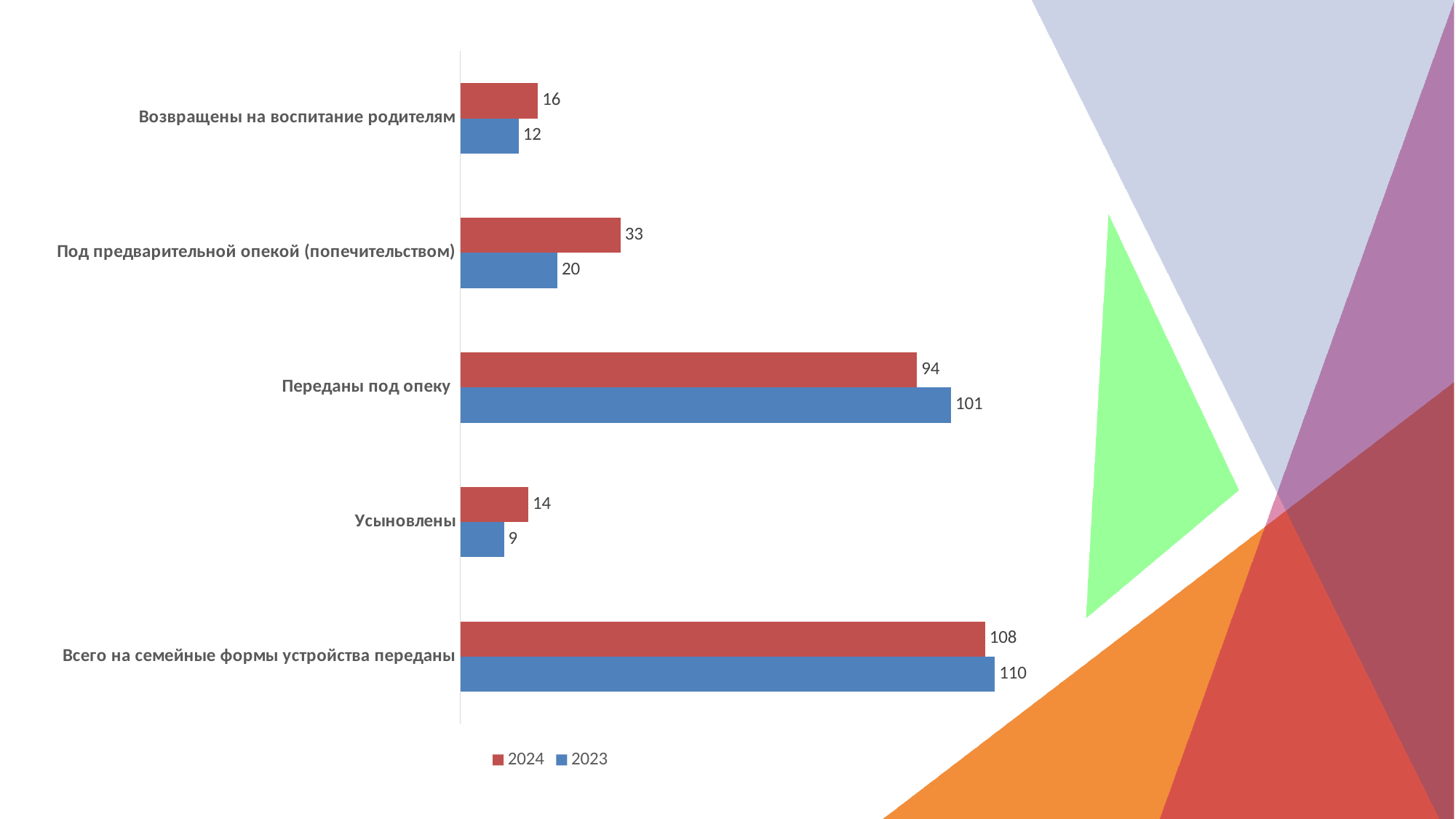
Which category has the lowest 2024 value? Усыновлены What is the difference between the 2024 and 2023 values for «Под предварительной опекой (попечительством)»? 13 Which is larger for «Возвращены на воспитание родителям»: the 2024 value or the 2023 value? 2024 Which category has the highest 2023 value? Всего на семейные формы устройства переданы What is the 2023 value for «Всего на семейные формы устройства переданы»? 110 What is the 2023 value for «Усыновлены»? 9 How many series does the legend list? 2 How many categories are shown on the chart? 5 What is the 2024 value for «Под предварительной опекой (попечительством)»? 33 What is the difference between the 2023 and 2024 values for «Переданы под опеку»? 7 What is the 2024 value for «Переданы под опеку»? 94 What kind of chart is shown on the slide? Bar chart